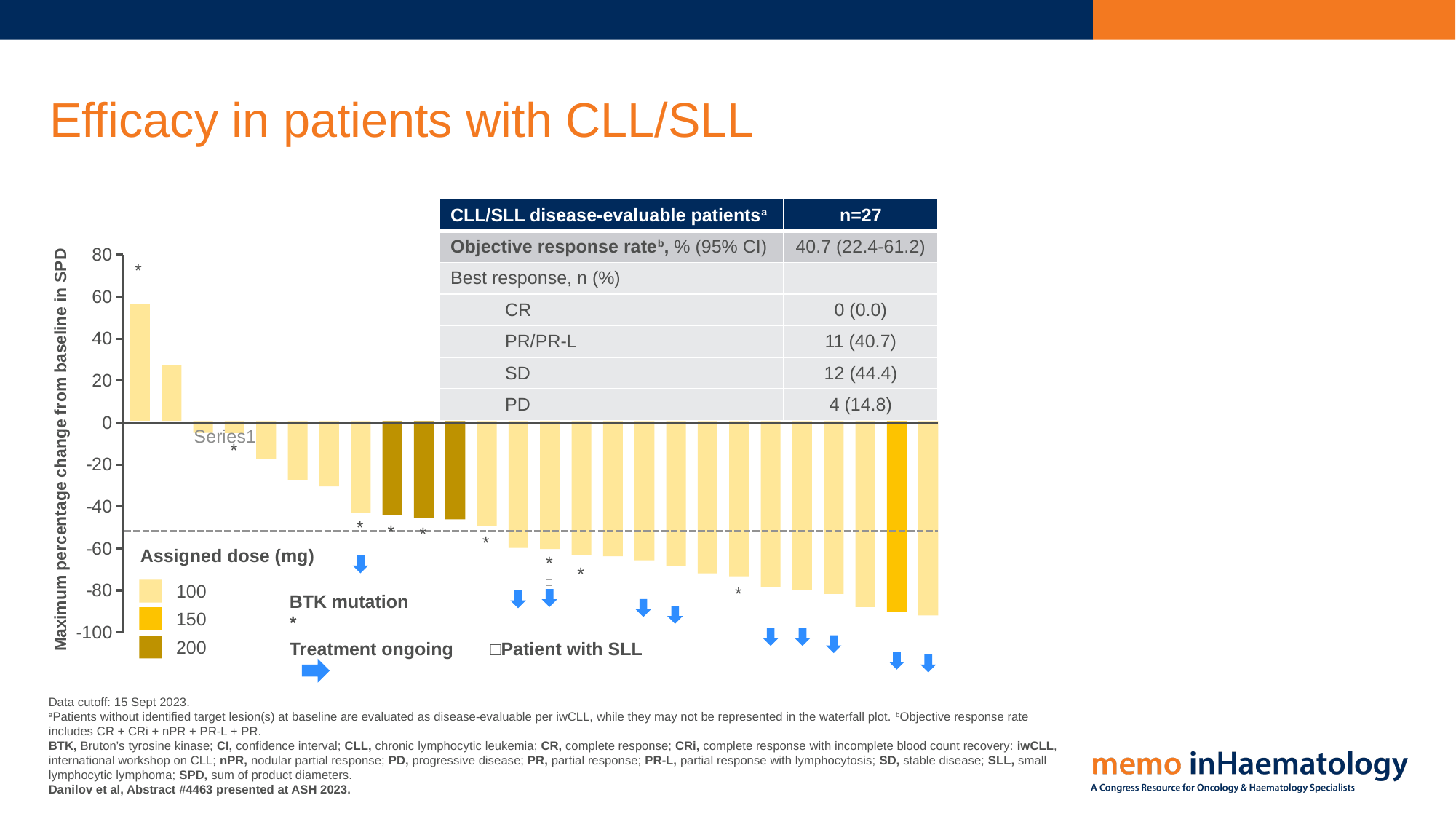
What is the label of the y axis of the chart? Maximum percentage change from baseline in SPD Is the value of the second bar from the left greater or less than 20? greater How many assigned dose categories does the chart legend list? 3 Is the value of the 150 mg dose bar greater or less than -80? less Which bar has the highest value in the chart? the first (leftmost) bar Is the value of the second bar from the left greater or less than 40? less Which is larger, the first bar or the second bar from the left? the first bar Do the bar values rise or fall moving from left to right along the x axis? fall What is the title of the chart legend? Assigned dose (mg) What kind of chart is shown on the slide? bar chart